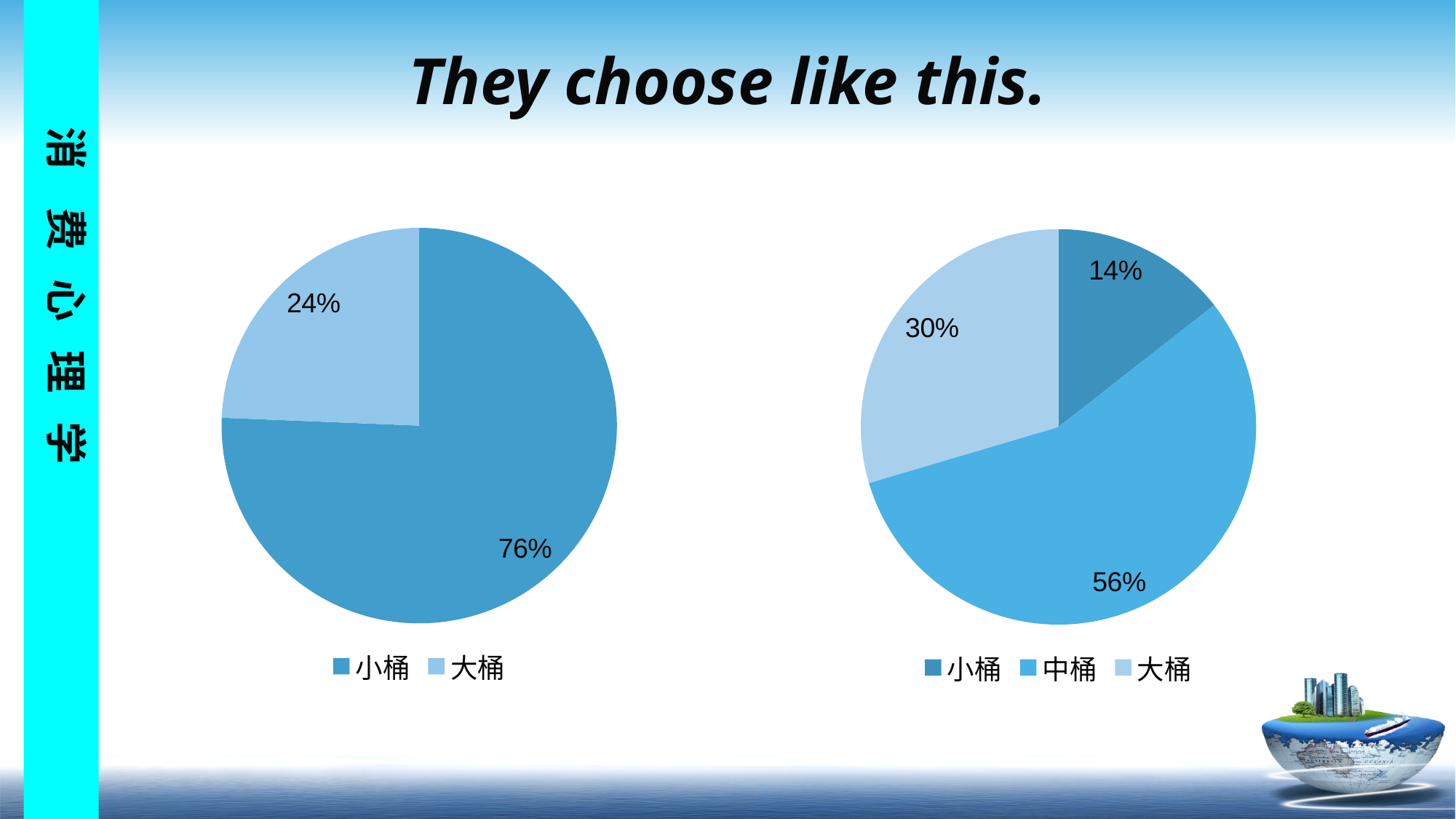
In the left pie chart, what share does 大桶 have? 24% In the right pie chart, which category has the smallest slice? 小桶 What type of chart is the left chart? Pie chart In the right pie chart, which category has the largest slice? 中桶 In the left pie chart, what is the difference between the 小桶 and 大桶 shares? 52% In the right pie chart, what share does 大桶 have? 30% What are the legend entries of the right chart? 小桶, 中桶, 大桶 In the right pie chart, what share does 中桶 have? 56% In the right pie chart, what share does 小桶 have? 14% In the right pie chart, which is larger, 大桶 or 小桶? 大桶 How many slices does the right pie chart have? 3 In the left pie chart, what share does 小桶 have? 76%